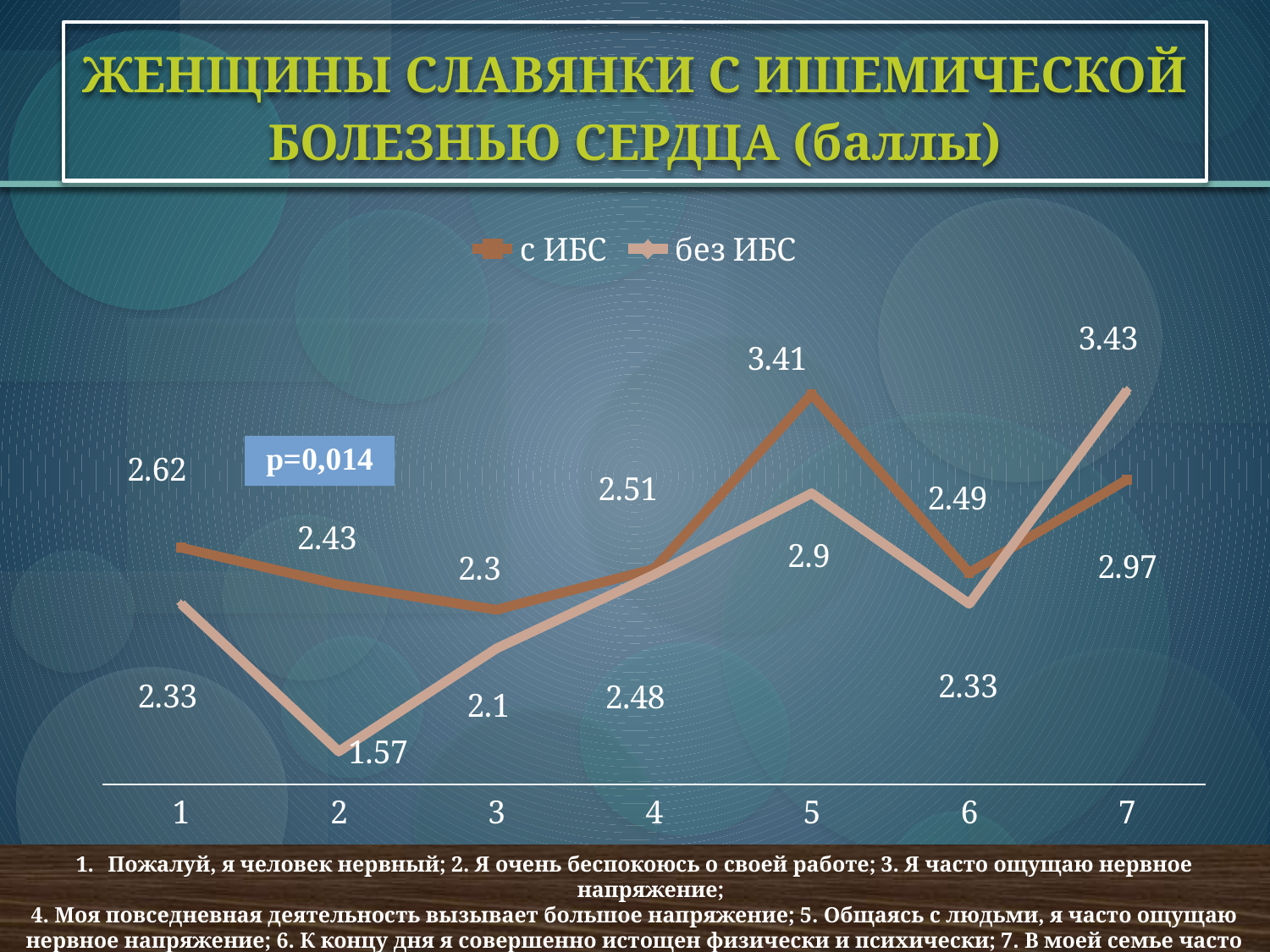
What is the value for category 7 in the "без ИБС" series? 3.43 What p-value is shown in the box on the chart? p=0,014 Which category has the lowest value in the "без ИБС" series? 2 What is the difference between the "с ИБС" and "без ИБС" values at category 5? 0.51 What is the value for category 5 in the "с ИБС" series? 3.41 How many series does the legend list? 2 How many categories are plotted along the x axis? 7 What is the difference between the "с ИБС" and "без ИБС" values at category 2? 0.86 What is the value for category 2 in the "без ИБС" series? 1.57 Which category has the highest value in the "с ИБС" series? 5 At category 7, which series has the larger value, "с ИБС" or "без ИБС"? без ИБС What type of chart is shown on the slide? line chart